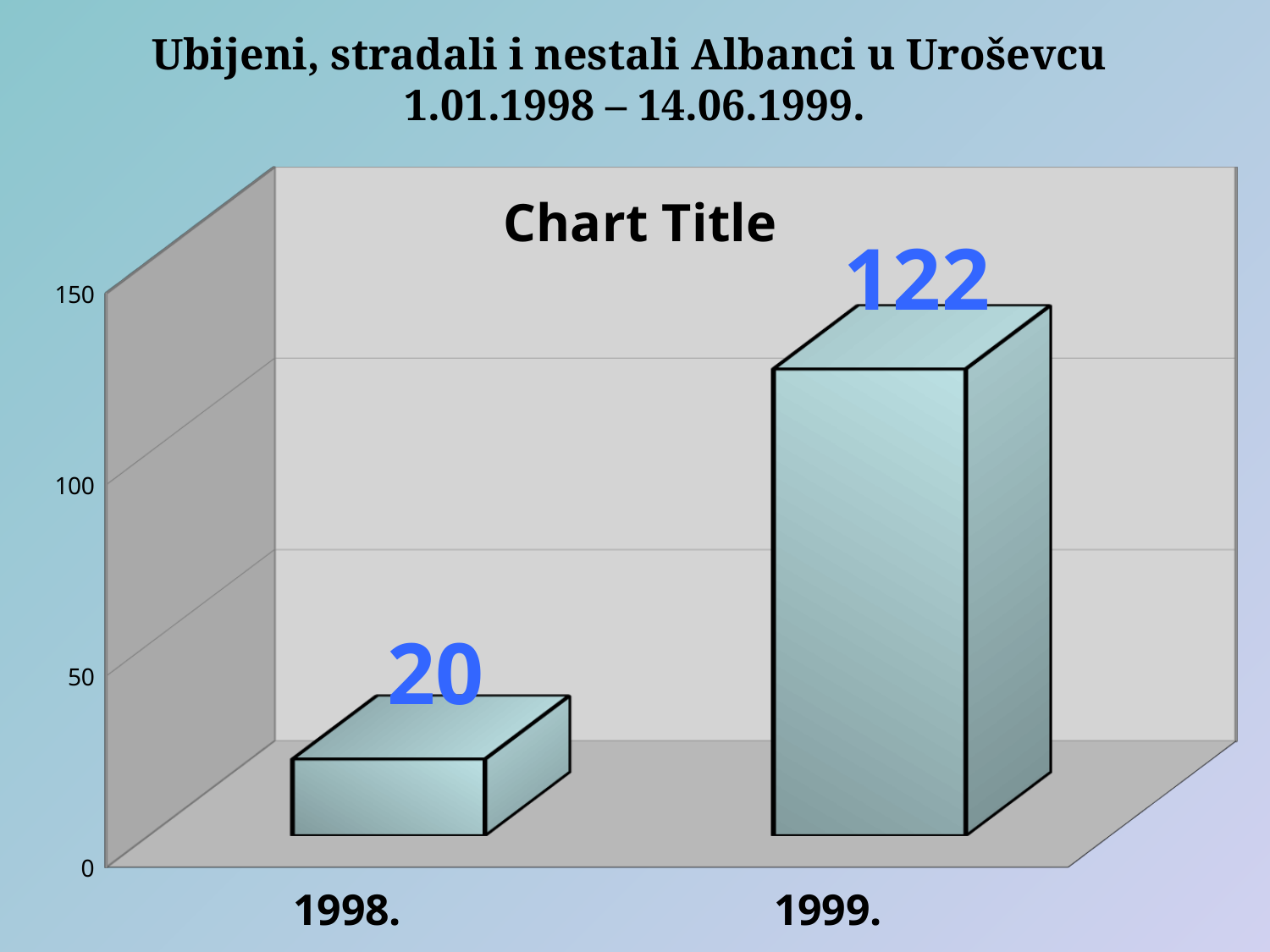
What is the value for 1998.? 20 What is the difference between the values for 1999. and 1998.? 102 What is the title printed inside the chart area? Chart Title Is the value for 1999. greater or less than 100? greater Which category has the lowest value? 1998. Which is larger, the value for 1998. or the value for 1999.? 1999. How many categories are shown on the x axis? 2 What kind of chart is shown on the slide? bar chart Which category has the highest value? 1999. What is the value for 1999.? 122 Is the value for 1998. greater or less than 50? less Do the values rise or fall from 1998. to 1999.? rise